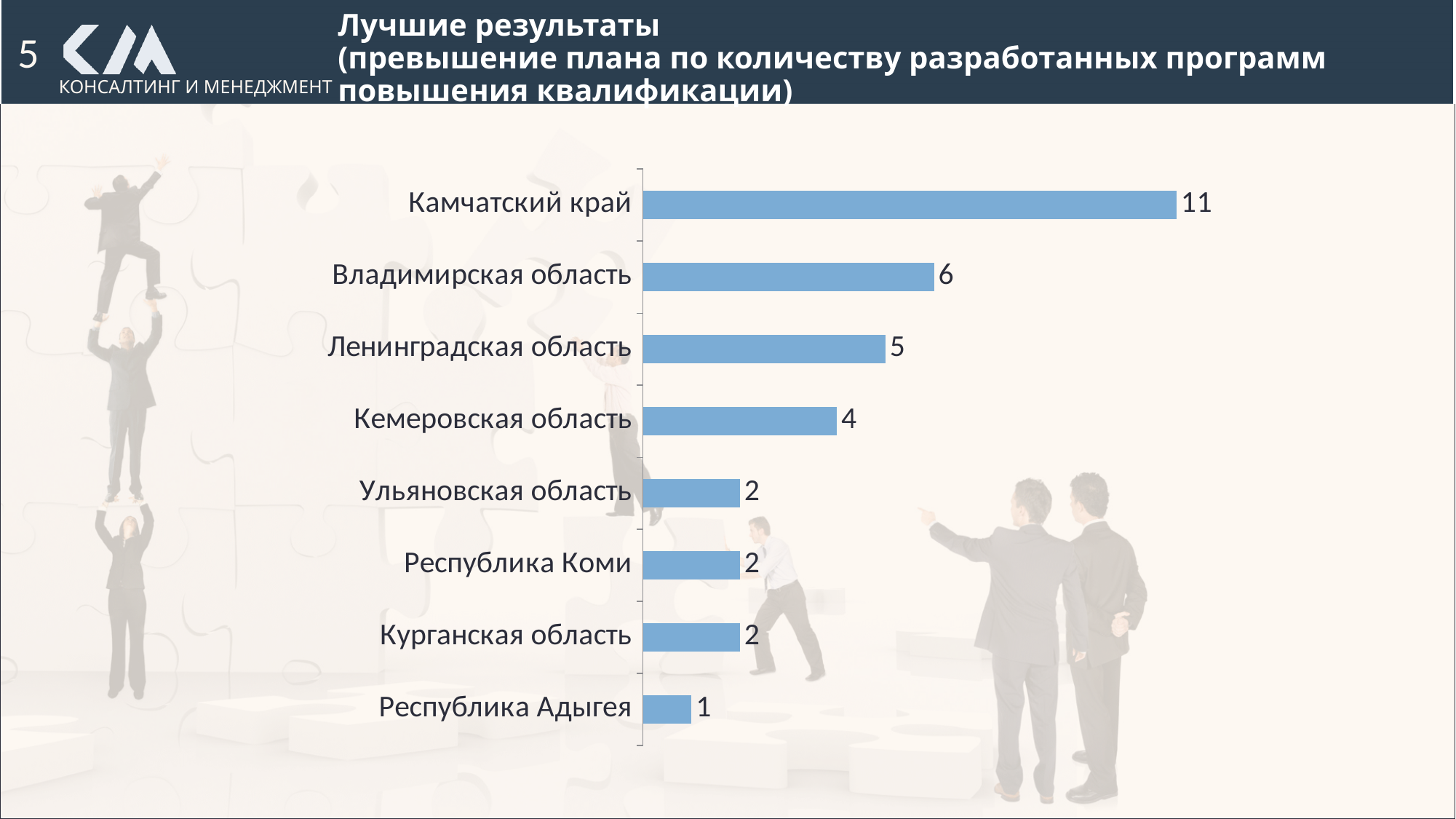
Which is larger, the value for Ленинградская область or the value for Кемеровская область? Ленинградская область What kind of chart is shown on the slide? Bar chart What is the value for Республика Адыгея? 1 Which category has the highest value? Камчатский край Which category has the lowest value? Республика Адыгея How many categories are shown in the chart? 8 What is the value for Владимирская область? 6 What is the value for Камчатский край? 11 What is the value for Ленинградская область? 5 What is the value for Кемеровская область? 4 What is the difference between the values for Камчатский край and Владимирская область? 5 What is the value for Ульяновская область? 2